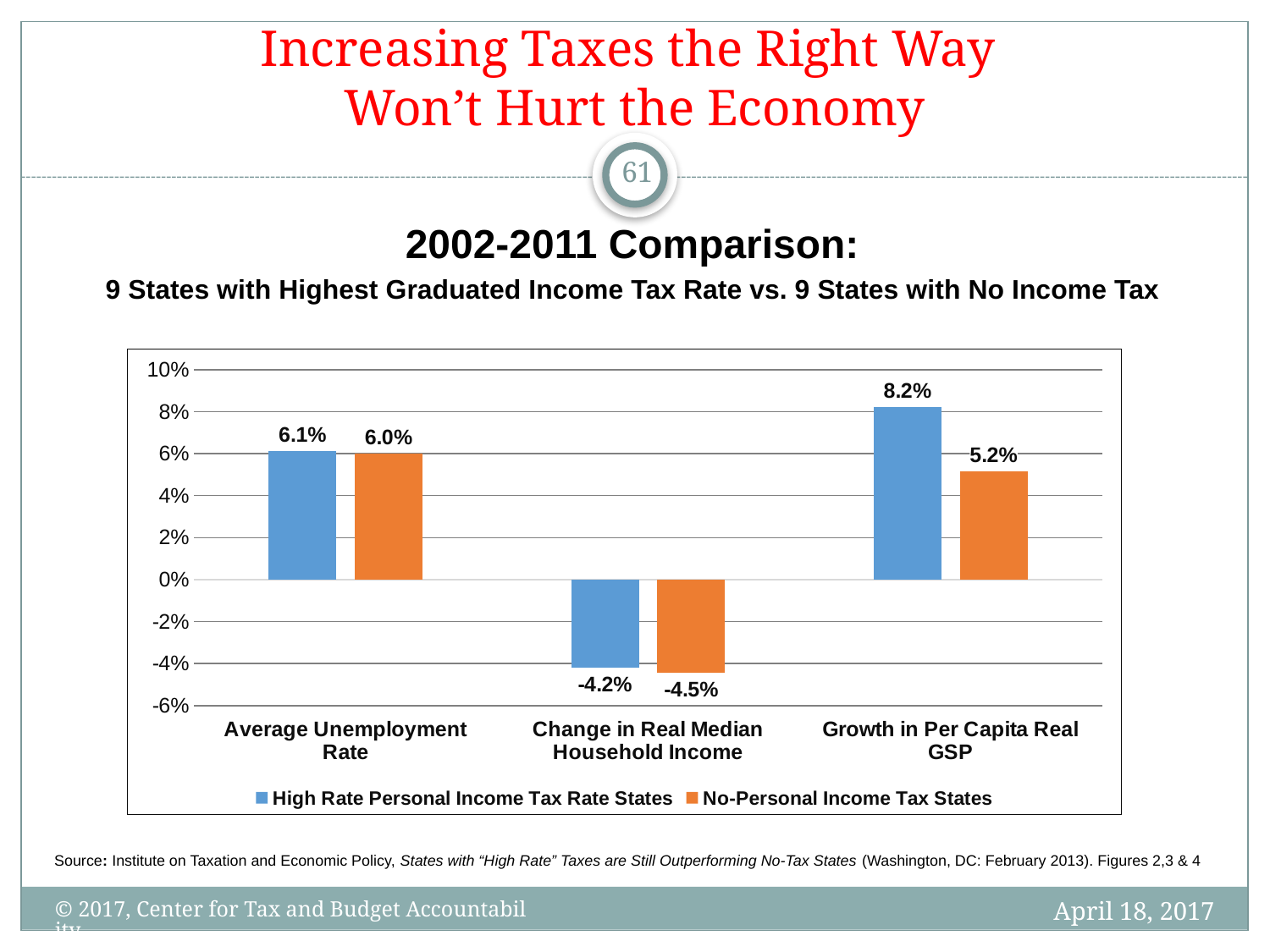
What is the Change in Real Median Household Income for High Rate Personal Income Tax Rate States? -4.2% For Growth in Per Capita Real GSP, which series has the larger value? High Rate Personal Income Tax Rate States What is the Growth in Per Capita Real GSP for No-Personal Income Tax States? 5.2% Which category has the highest value for High Rate Personal Income Tax Rate States? Growth in Per Capita Real GSP How many categories are shown on the x axis of the chart? 3 What kind of chart is shown on the slide? Bar chart Which category has the lowest value for No-Personal Income Tax States? Change in Real Median Household Income Is the Growth in Per Capita Real GSP for High Rate Personal Income Tax Rate States greater or less than 8%? greater What is the Change in Real Median Household Income for No-Personal Income Tax States? -4.5% What is the difference between the Growth in Per Capita Real GSP for High Rate Personal Income Tax Rate States and No-Personal Income Tax States? 3.0% What is the Average Unemployment Rate for High Rate Personal Income Tax Rate States? 6.1% How many series does the chart's legend list? 2